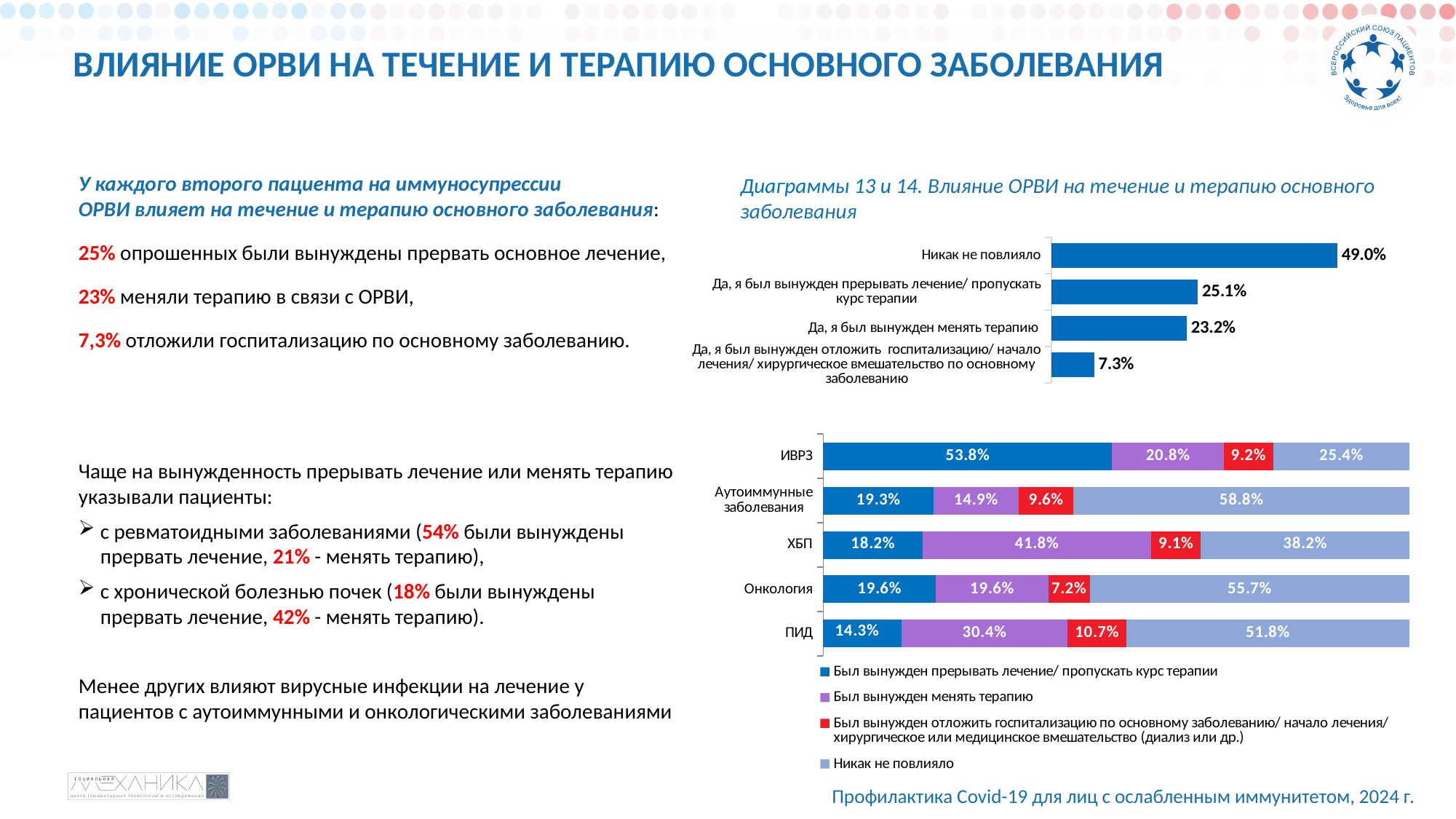
How many series does the legend of the bottom chart list? 4 In the top chart, what is the value for "Никак не повлияло"? 49.0% In the bottom chart, what is the total of the ИВРЗ bar? 109.2% In the top chart, how many categories are shown? 4 In the top chart, what is the value for "Да, я был вынужден менять терапию"? 23.2% In the bottom chart, what is the value of "Никак не повлияло" for Аутоиммунные заболевания? 58.8% In the bottom chart, is the "Был вынужден отложить госпитализацию" value larger for ПИД or for Онкология? ПИД In the top chart, what is the difference between "Никак не повлияло" and "Да, я был вынужден прерывать лечение/ пропускать курс терапии"? 23.9% What kind of chart is the bottom chart? Stacked bar chart In the bottom chart, what is the value of "Был вынужден менять терапию" for ХБП? 41.8% In the top chart, which category has the lowest value? Да, я был вынужден отложить госпитализацию/ начало лечения/ хирургическое вмешательство по основному заболеванию In the bottom chart, which category has the highest value for "Был вынужден прерывать лечение/ пропускать курс терапии"? ИВРЗ